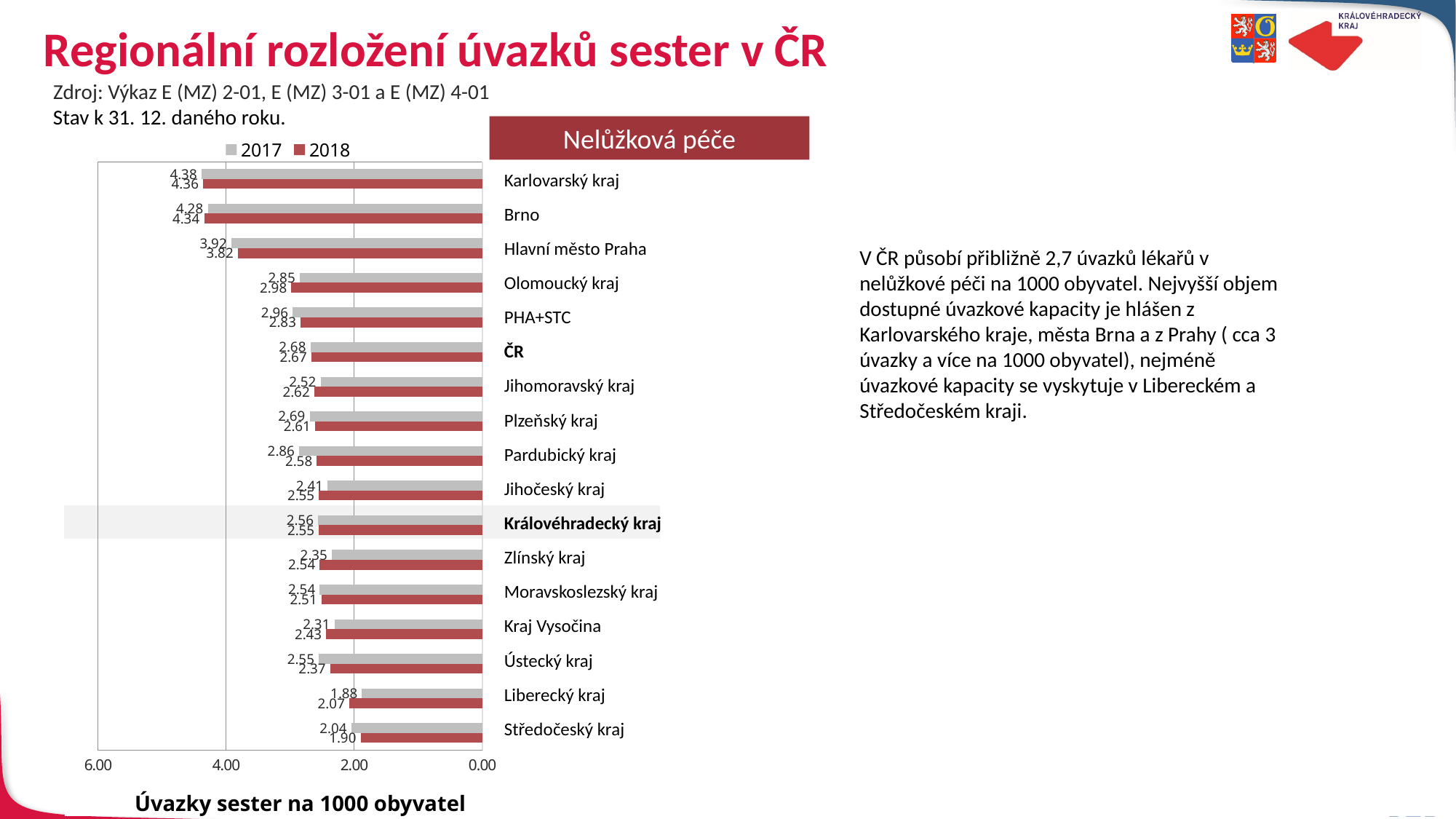
Which category has the lowest 2018 value? Středočeský kraj Which category has the lowest 2017 value? Liberecký kraj Which category has the highest 2018 value? Karlovarský kraj How many series does the legend list? 2 What kind of chart is shown on the slide? bar chart Is the 2018 value for Hlavní město Praha greater or less than 4.00? less What is the 2018 value for Karlovarský kraj? 4.36 Which is larger for Brno: the 2017 value or the 2018 value? 2018 What is the 2017 value for Pardubický kraj? 2.86 What is the difference between the 2017 and 2018 values for Pardubický kraj? 0.28 How many categories are shown on the chart? 17 What is the 2018 value for Královéhradecký kraj? 2.55